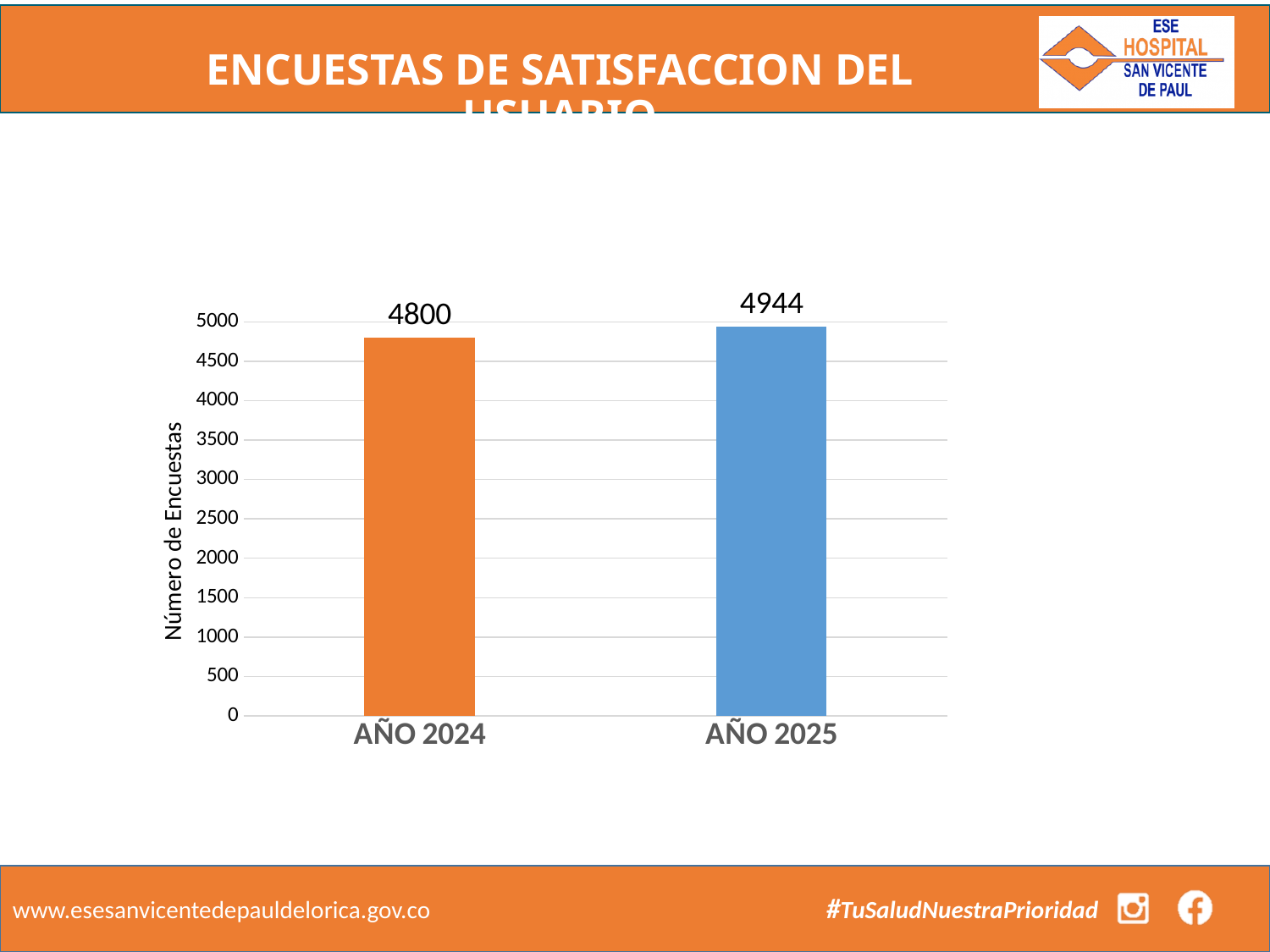
What kind of chart is shown on the slide? bar chart Do the values rise or fall from AÑO 2024 to AÑO 2025? rise Which category has the lowest value? AÑO 2024 Is the value for AÑO 2025 greater or less than 5000? less What is the value for AÑO 2024? 4800 What is the value for AÑO 2025? 4944 What is the difference between the values for AÑO 2025 and AÑO 2024? 144 Which is larger, the value for AÑO 2024 or AÑO 2025? AÑO 2025 How many categories are shown on the x axis? 2 Is the value for AÑO 2024 greater or less than 4500? greater What is the label of the vertical axis? Número de Encuestas Which category has the highest value? AÑO 2025